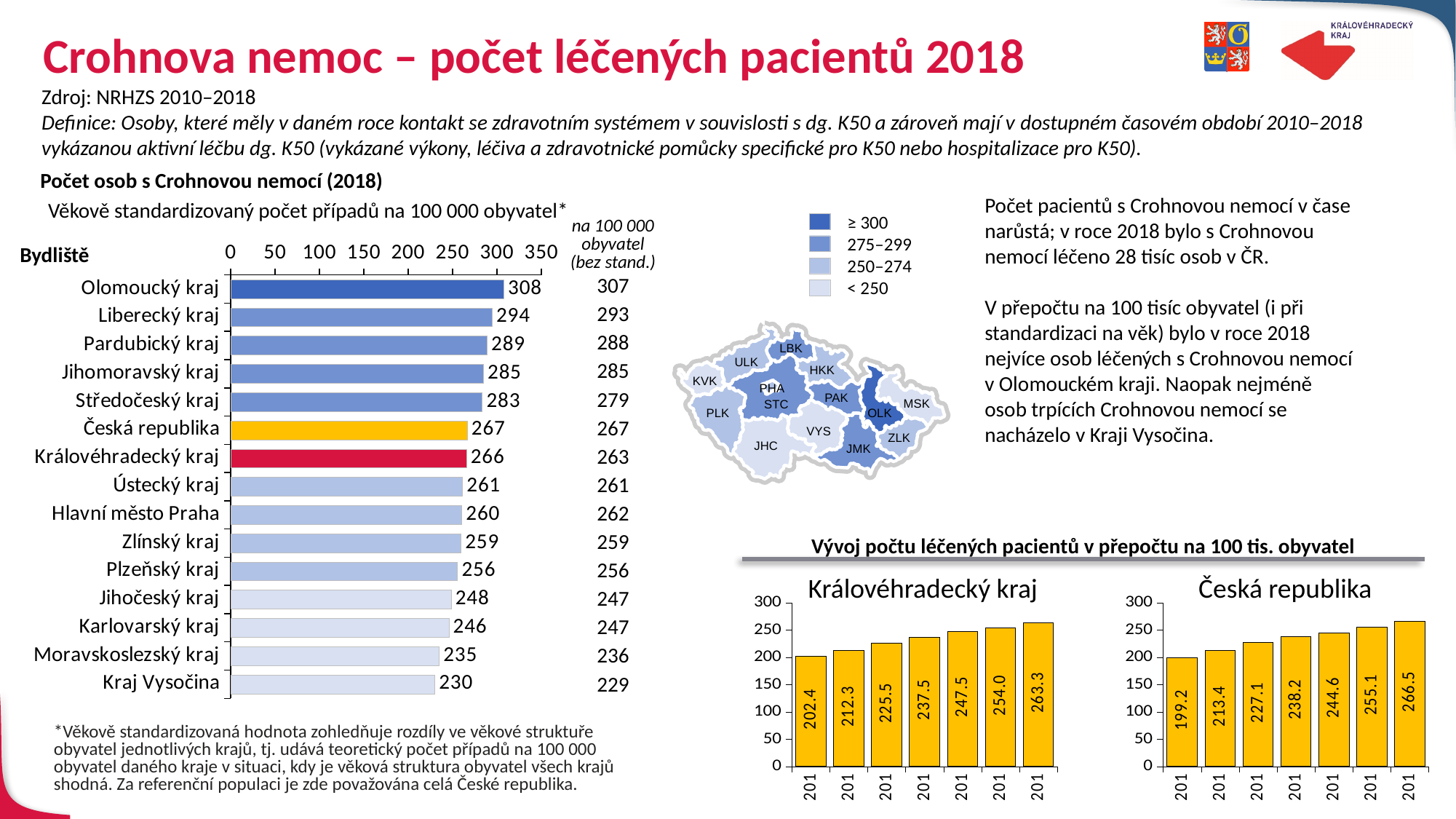
In the bar chart 'Počet osob s Crohnovou nemocí (2018)', which has the larger age-standardized value, Česká republika or Královéhradecký kraj? Česká republika In the 'Česká republika' chart at the bottom right, what is the value of the first (leftmost) bar? 199.2 In the 'Královéhradecký kraj' chart at the bottom right, what is the value of the last (rightmost) bar? 263.3 In the 'Česká republika' chart at the bottom right, do the values rise or fall from left to right? Rise In the bar chart 'Počet osob s Crohnovou nemocí (2018)', what is the difference between the age-standardized values for Olomoucký kraj and Kraj Vysočina? 78 How many bars are shown in the 'Královéhradecký kraj' chart at the bottom right? 7 In the bar chart 'Počet osob s Crohnovou nemocí (2018)', which region has the lowest age-standardized value? Kraj Vysočina In the bar chart 'Počet osob s Crohnovou nemocí (2018)', what is the age-standardized value for Olomoucký kraj? 308 What type of chart is 'Počet osob s Crohnovou nemocí (2018)'? Bar chart How many bars (regions including Česká republika) are shown in the bar chart 'Počet osob s Crohnovou nemocí (2018)'? 15 In the bar chart 'Počet osob s Crohnovou nemocí (2018)', which region has the highest age-standardized value? Olomoucký kraj In the bar chart 'Počet osob s Crohnovou nemocí (2018)', what is the age-standardized value for Liberecký kraj? 294